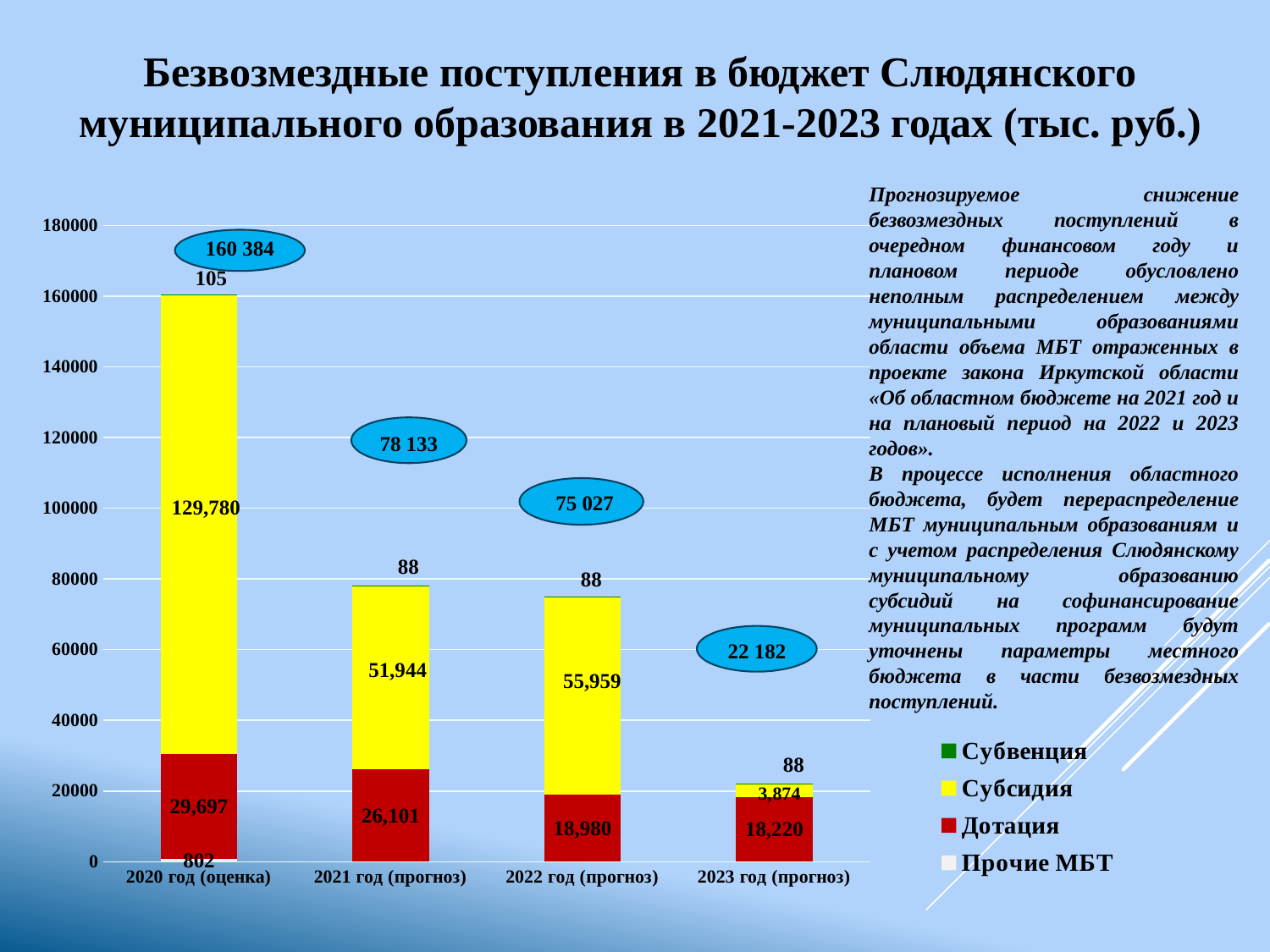
Do the total values rise or fall from 2020 to 2023? fall Which is larger: the Дотация value for 2020 год (оценка) or for 2022 год (прогноз)? 2020 год (оценка) What is the total shown for the 2021 год (прогноз) bar? 78 133 What is the Субвенция value for 2022 год (прогноз)? 88 Which year has the lowest Дотация value? 2023 год (прогноз) Which year has the highest total of безвозмездные поступления? 2020 год (оценка) How many series does the legend list? 4 How many years (categories) are shown on the x axis? 4 What is the Дотация value for 2021 год (прогноз)? 26,101 What is the Субсидия value for 2023 год (прогноз)? 3,874 What is the Субсидия value for 2020 год (оценка)? 129,780 What is the difference between the Субсидия values for 2022 год (прогноз) and 2021 год (прогноз)? 4,015